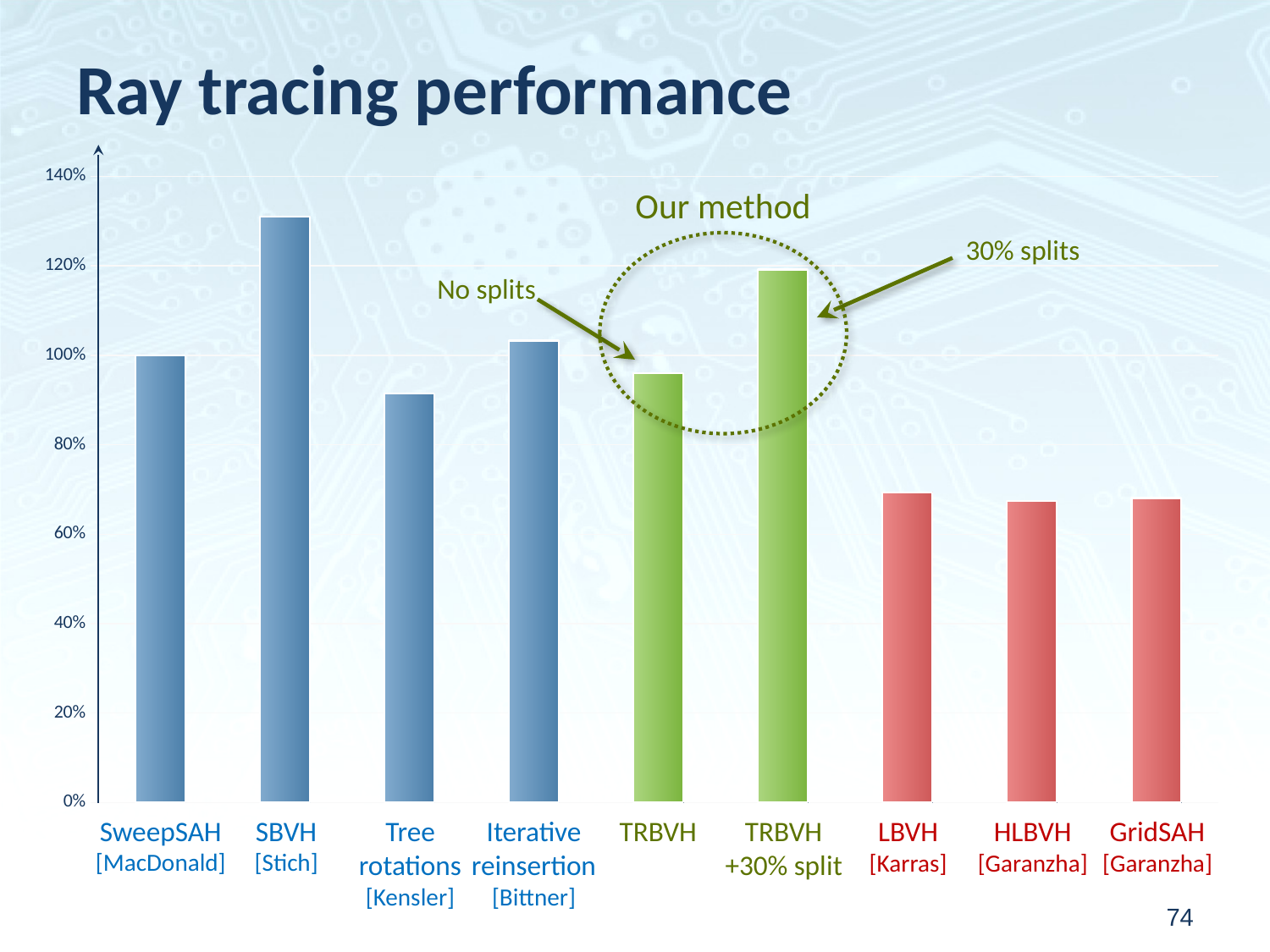
What kind of chart is shown on the slide? bar chart Which category has the highest value? SBVH Which two bars are circled and labelled "Our method"? TRBVH and TRBVH +30% split How many categories (bars) are shown in the chart? 9 Is the value for TRBVH +30% split greater or less than 100%? greater Is the value for LBVH greater or less than 80%? less What is the title of the chart? Ray tracing performance Which is larger, the value for TRBVH or the value for TRBVH +30% split? TRBVH +30% split What is the value for SweepSAH? 100% Is the value for Tree rotations greater or less than 100%? less Which is larger, the value for Iterative reinsertion or the value for SBVH? SBVH